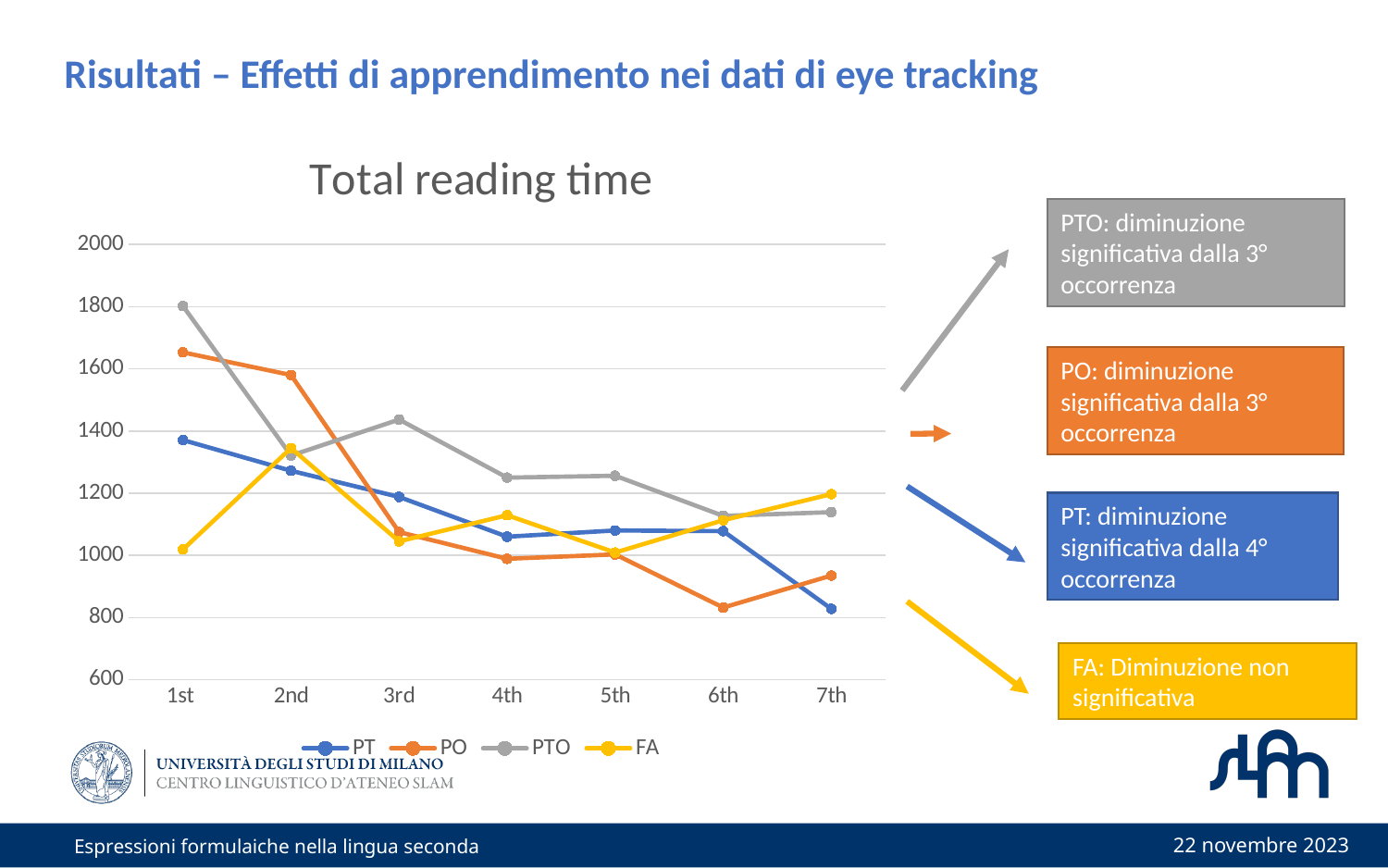
What are the series names listed in the legend? PT, PO, PTO, FA Is the value for PO at the 6th occurrence greater or less than 1000? less Which series has the highest value at the 1st occurrence? PTO How many occurrences (points) are shown along the x axis? 7 How many series does the legend list? 4 Which series has the lowest value at the 1st occurrence? FA What is the title of the chart? Total reading time At the 7th occurrence, which is larger: FA or PT? FA Does the PT series rise or fall overall from the 1st to the 7th occurrence? fall What kind of chart is shown on the slide? line chart Is the value for PTO at the 1st occurrence greater or less than 1600? greater Is the value for PT at the 7th occurrence greater or less than 1000? less